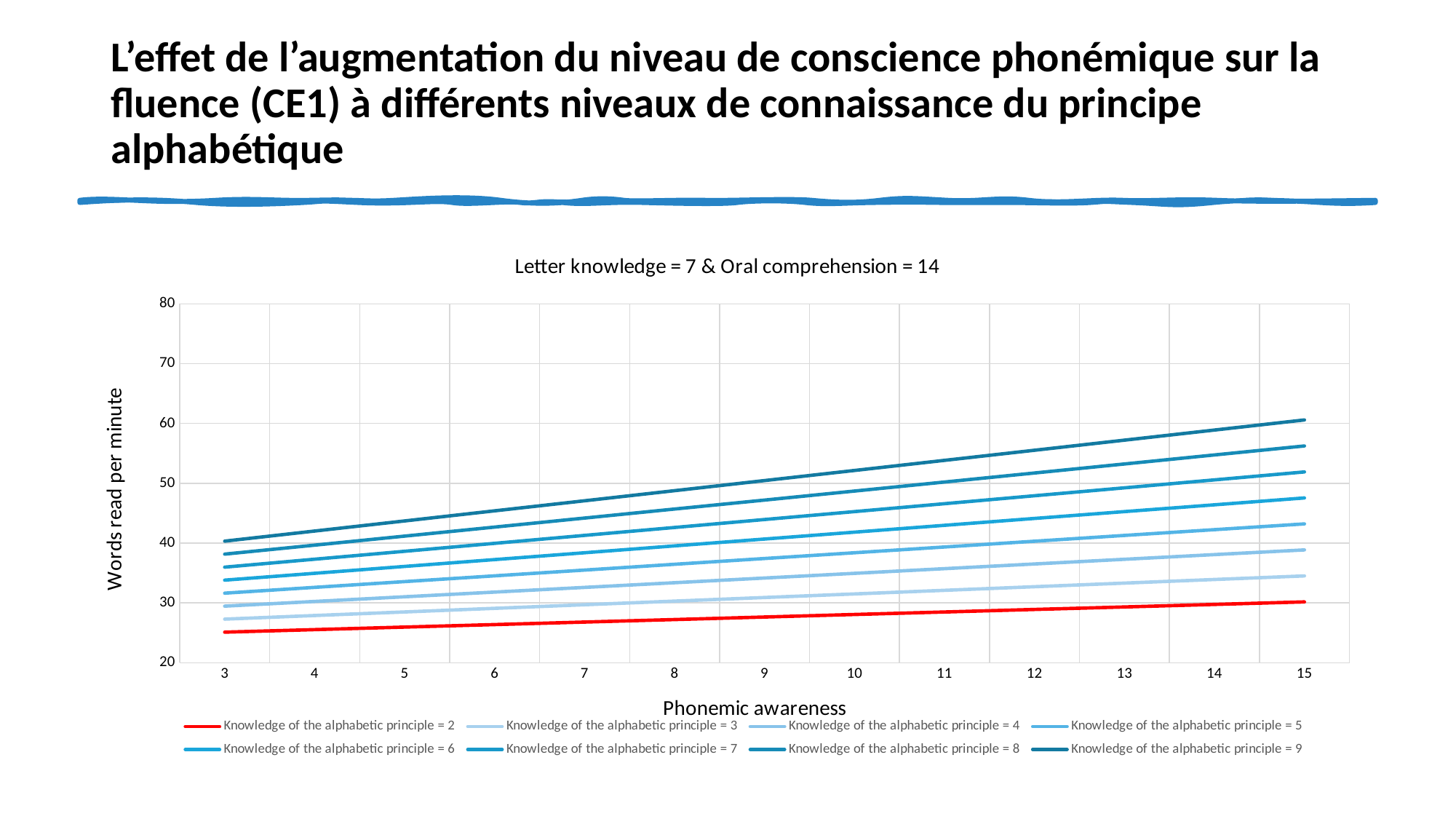
Do the lines rise or fall as phonemic awareness increases from 3 to 15? rise Which series has the lowest words read per minute at phonemic awareness = 3? Knowledge of the alphabetic principle = 2 At phonemic awareness = 15, which is larger: the value for 'Knowledge of the alphabetic principle = 8' or for 'Knowledge of the alphabetic principle = 4'? Knowledge of the alphabetic principle = 8 How many series does the legend list? 8 What is the label of the y axis? Words read per minute Is the value for 'Knowledge of the alphabetic principle = 2' at phonemic awareness = 3 greater or less than 30? less How many values are marked on the x axis (Phonemic awareness)? 13 Is the value for 'Knowledge of the alphabetic principle = 9' at phonemic awareness = 15 greater or less than 50? greater What is the title of the chart? Letter knowledge = 7 & Oral comprehension = 14 Is the value for 'Knowledge of the alphabetic principle = 3' at phonemic awareness = 15 greater or less than 40? less What kind of chart is shown on the slide? line chart Which series has the highest words read per minute at phonemic awareness = 15? Knowledge of the alphabetic principle = 9